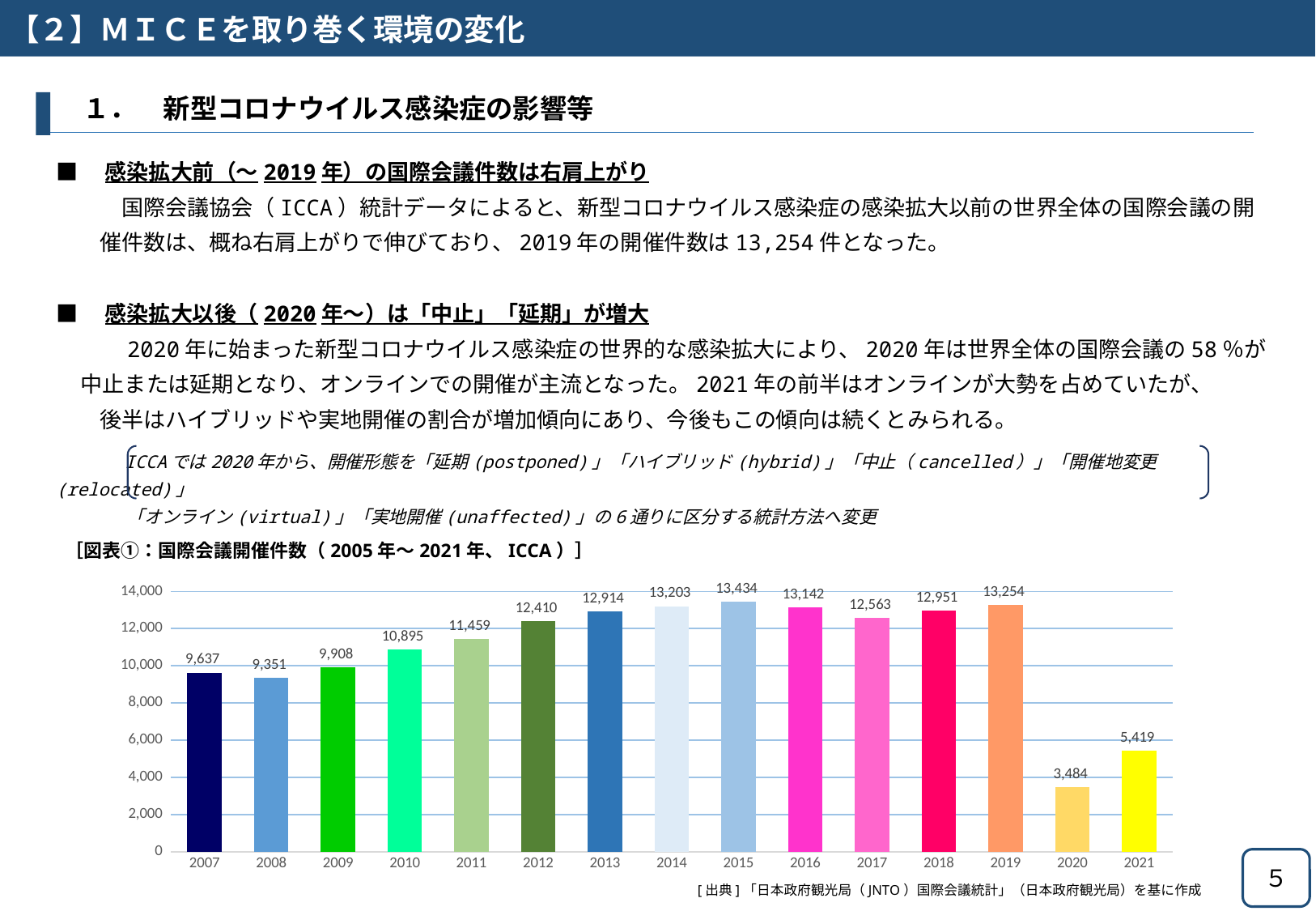
Which year has the lowest value in the chart? 2020 What is the value for 2012 in the chart? 12,410 What is the difference between the values for 2019 and 2020? 9,770 What is the value for 2020 in the chart? 3,484 Do the values generally rise or fall from 2007 to 2015? rise Which is larger, the value for 2013 or the value for 2017? 2013 Is the value for 2021 greater or less than 6,000? less What is the value for 2019 in the chart? 13,254 Which year has the highest value in the chart? 2015 What is the difference between the values for 2021 and 2020? 1,935 How many years (bars) are plotted in the chart? 15 What type of chart is shown on the slide? bar chart